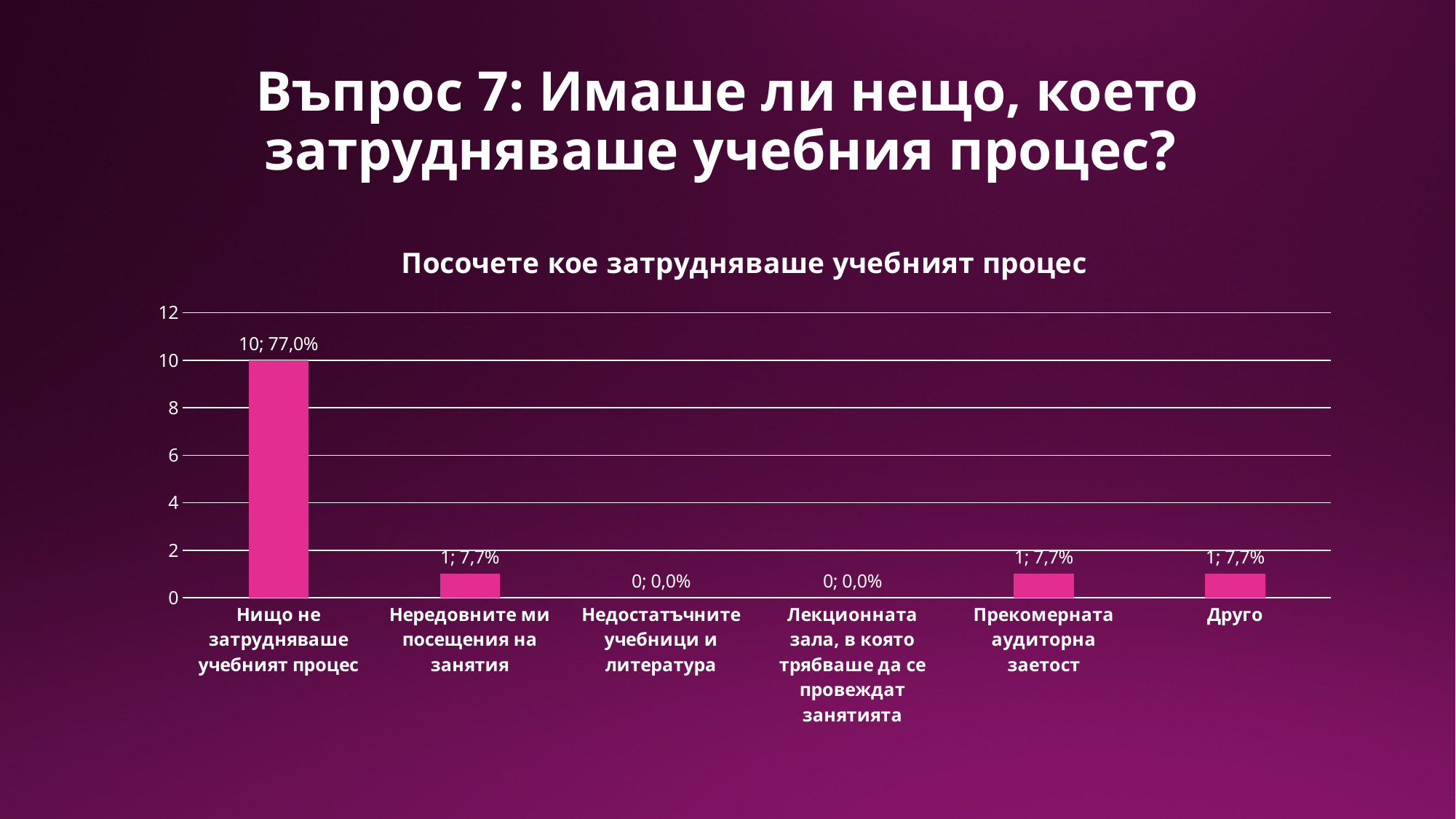
Is the value for "Нищо не затрудняваше учебният процес" greater or less than 8? greater What is the maximum value shown on the vertical axis? 12 What is the difference in count between "Нищо не затрудняваше учебният процес" and "Нередовните ми посещения на занятия"? 9 What is the data label shown for the category "Прекомерната аудиторна заетост"? 1; 7,7% Which category has the highest value? Нищо не затрудняваше учебният процес What is the data label shown for the category "Друго"? 1; 7,7% What is the title of the chart? Посочете кое затрудняваше учебният процес How many categories are shown on the x axis? 6 What kind of chart is shown on the slide? bar chart What is the data label shown for the category "Недостатъчните учебници и литература"? 0; 0,0% What is the data label shown for the category "Нищо не затрудняваше учебният процес"? 10; 77,0% Which has a larger value: "Нередовните ми посещения на занятия" or "Лекционната зала, в която трябваше да се провеждат занятията"? Нередовните ми посещения на занятия